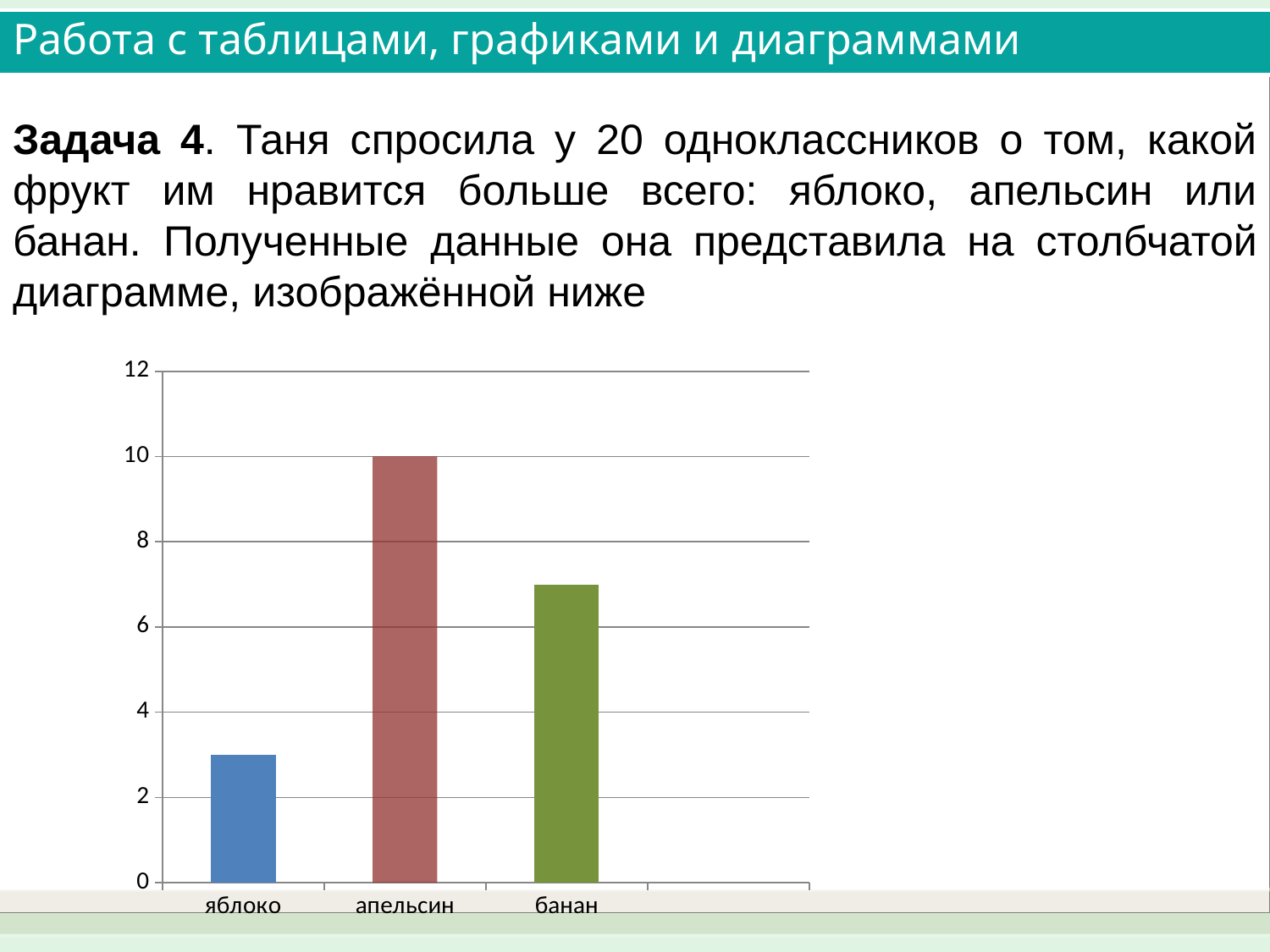
What is the highest value shown on the vertical axis? 12 How many categories are shown on the chart? 3 Which category has the highest bar? апельсин What kind of chart is shown on the slide? bar chart What is the value for апельсин? 10 Which is larger, the value for апельсин or the value for банан? апельсин Is the value for яблоко greater or less than 4? less Which is larger, the value for банан or the value for яблоко? банан Which category has the lowest bar? яблоко Is the value for яблоко greater or less than 2? greater Is the value for банан greater or less than 6? greater